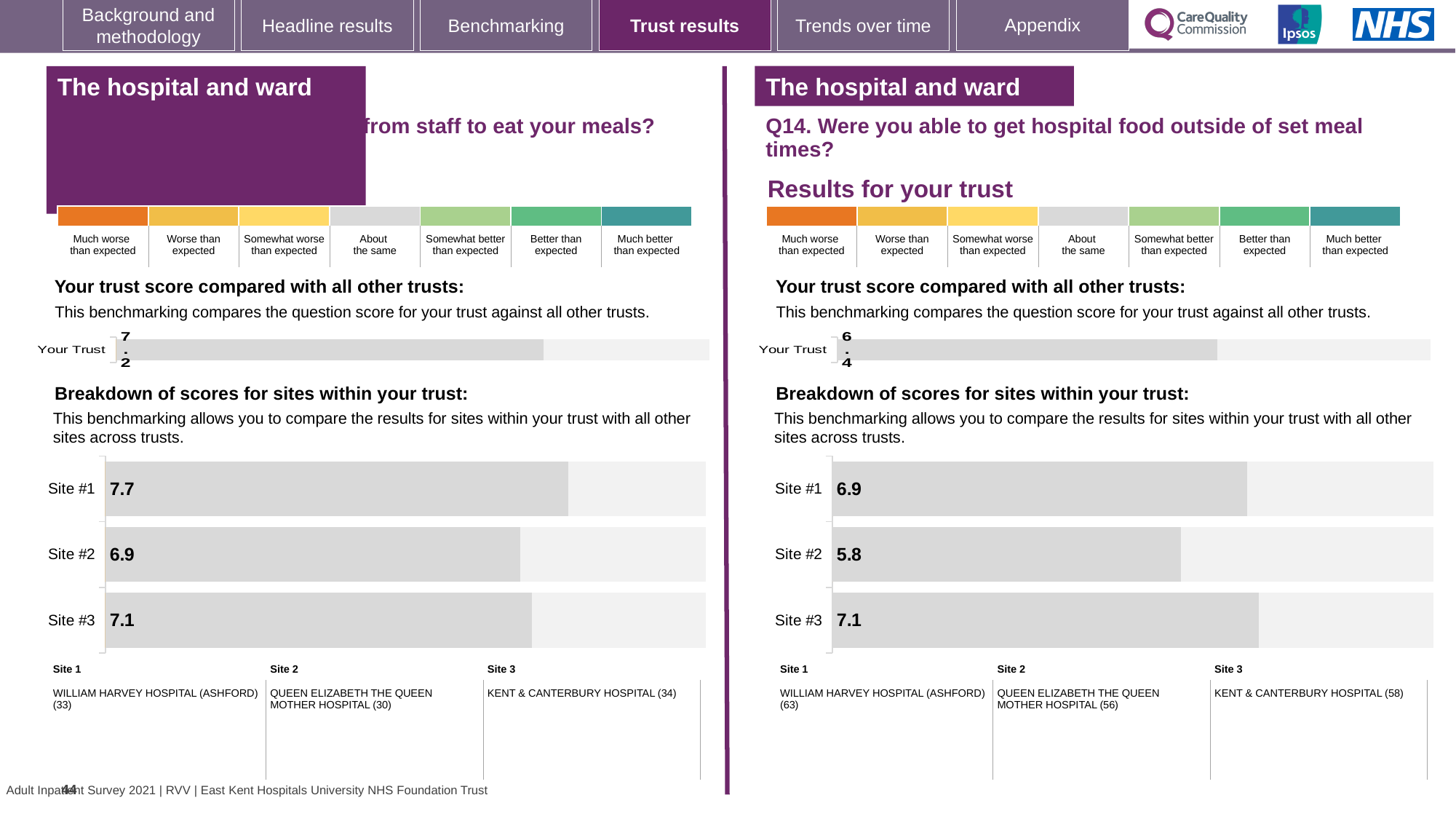
On the right-hand chart for Q14, what is the score for Site #1? 6.9 How many sites are shown in the right-hand site breakdown chart for Q14? 3 On the left-hand site breakdown chart, which is larger: the score for Site #2 or the score for Site #3? Site #3 On the right-hand chart for Q14, what is the difference between the Site #3 score and the Site #2 score? 1.3 On the right-hand chart for Q14, what is the 'Your Trust' score? 6.4 On the right-hand chart for Q14, what is the score for Site #3? 7.1 On the right-hand chart for Q14, which site has the lowest score? Site #2 On the right-hand chart for Q14 (hospital food outside of set meal times), what is the score for Site #2? 5.8 On the left-hand chart, what is the 'Your Trust' score? 7.2 On the left-hand site breakdown chart, what is the score for Site #2? 6.9 On the left-hand site breakdown chart, which site has the highest score? Site #1 On the left-hand site breakdown chart, what is the score for Site #1? 7.7